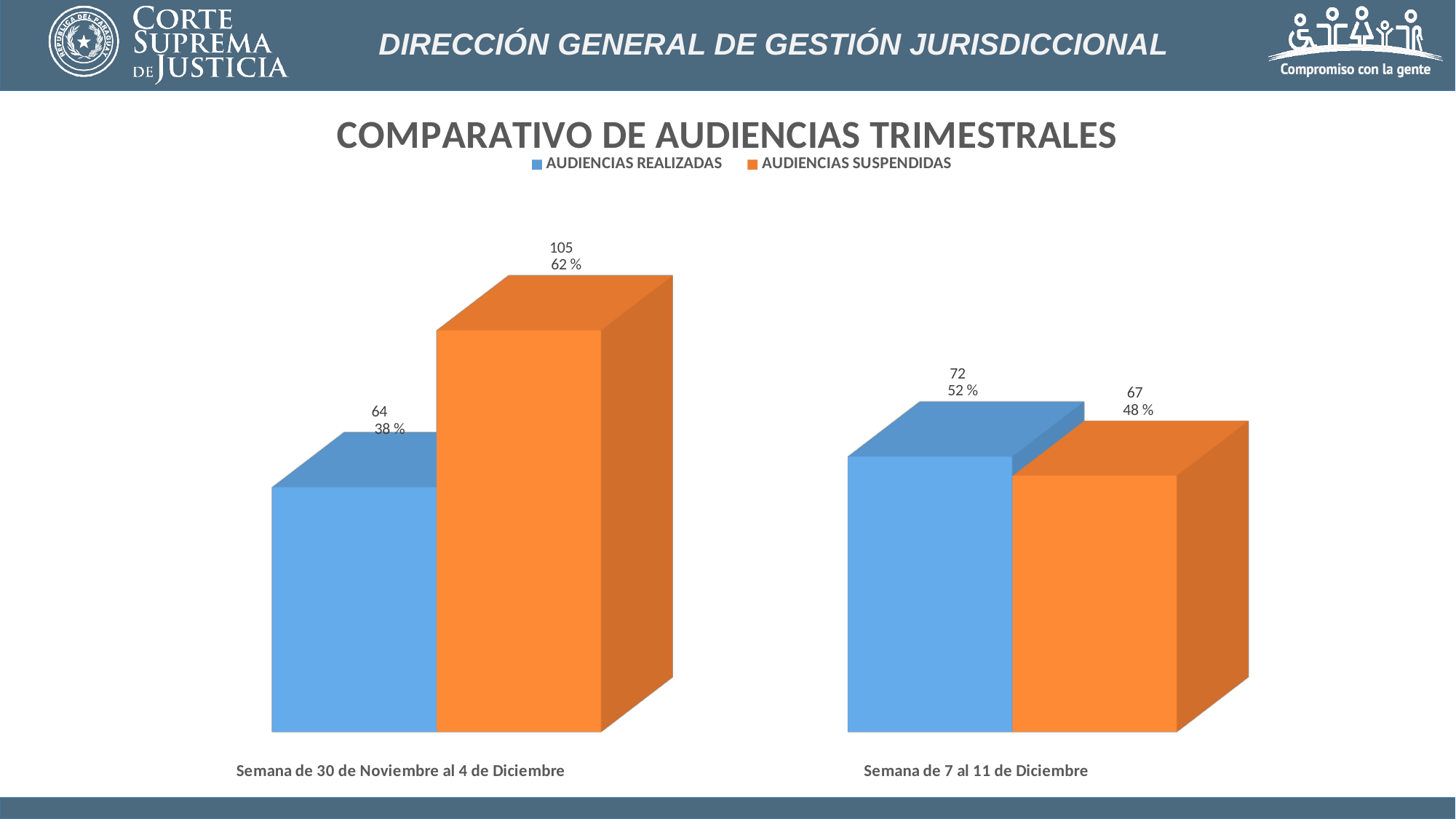
Which series has the highest value in Semana de 30 de Noviembre al 4 de Diciembre? AUDIENCIAS SUSPENDIDAS What is the value of AUDIENCIAS SUSPENDIDAS for Semana de 7 al 11 de Diciembre? 67 What is the difference between AUDIENCIAS REALIZADAS and AUDIENCIAS SUSPENDIDAS in Semana de 7 al 11 de Diciembre? 5 What percentage is shown for AUDIENCIAS REALIZADAS in Semana de 7 al 11 de Diciembre? 52 % What is the value of AUDIENCIAS REALIZADAS for Semana de 30 de Noviembre al 4 de Diciembre? 64 What is the value of AUDIENCIAS REALIZADAS for Semana de 7 al 11 de Diciembre? 72 How many series does the legend list? 2 What is the value of AUDIENCIAS SUSPENDIDAS for Semana de 30 de Noviembre al 4 de Diciembre? 105 What is the difference between AUDIENCIAS SUSPENDIDAS and AUDIENCIAS REALIZADAS in Semana de 30 de Noviembre al 4 de Diciembre? 41 What kind of chart is shown on the slide? Bar chart What percentage is shown for AUDIENCIAS SUSPENDIDAS in Semana de 30 de Noviembre al 4 de Diciembre? 62 % Which is larger: AUDIENCIAS REALIZADAS in Semana de 30 de Noviembre al 4 de Diciembre or AUDIENCIAS REALIZADAS in Semana de 7 al 11 de Diciembre? Semana de 7 al 11 de Diciembre